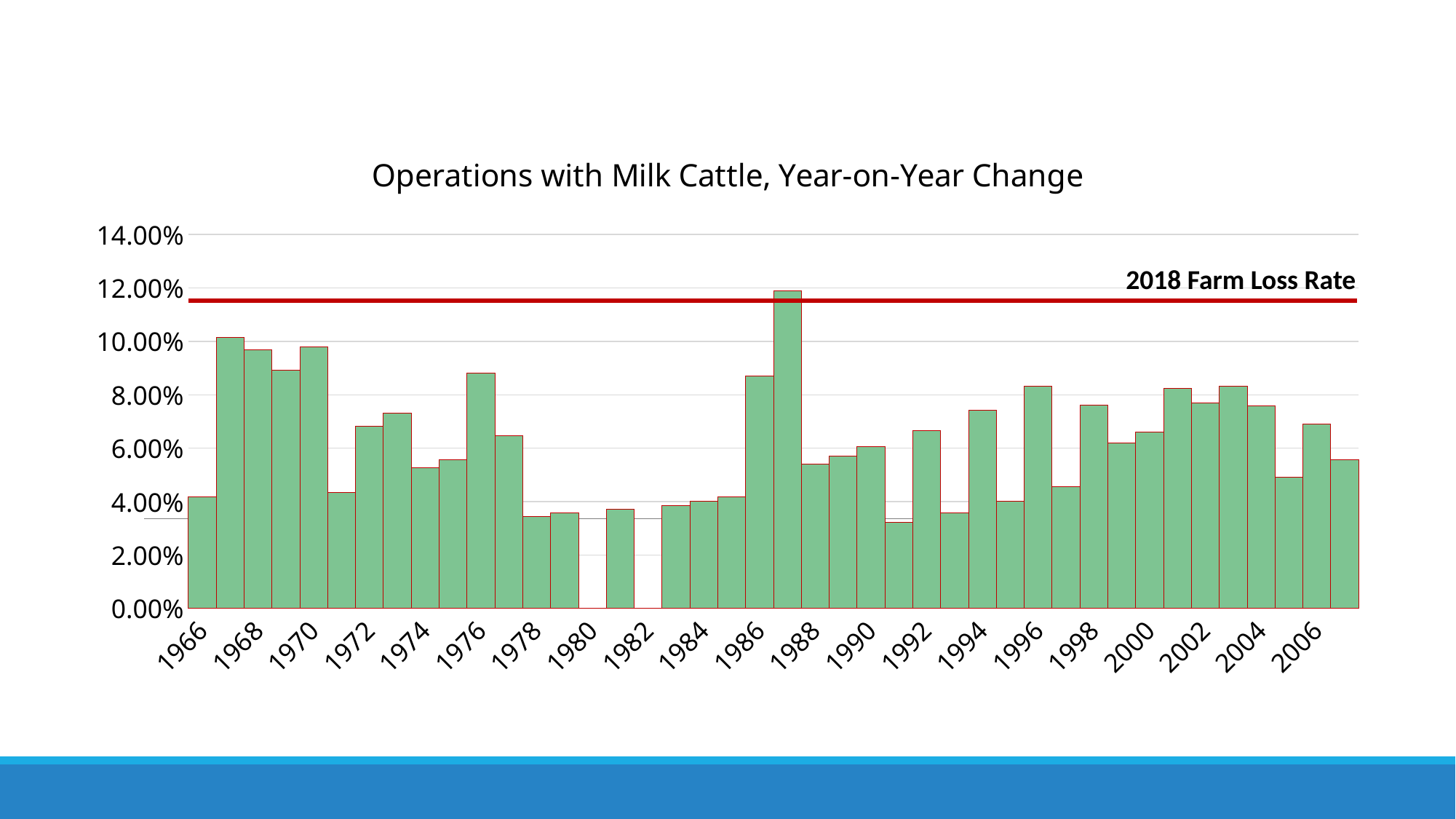
Is the value for 1968 greater or less than 8.00%? greater What kind of chart is shown on the slide? bar chart Is the value for 1994 greater or less than 8.00%? less Which year has the larger value, 1968 or 1978? 1968 What is the title of the chart? Operations with Milk Cattle, Year-on-Year Change Which year has the larger value, 1994 or 1996? 1996 Is the value for 2000 greater or less than 6.00%? greater Which year has the larger value, 1986 or 1988? 1986 What label is given to the horizontal red reference line on the chart? 2018 Farm Loss Rate